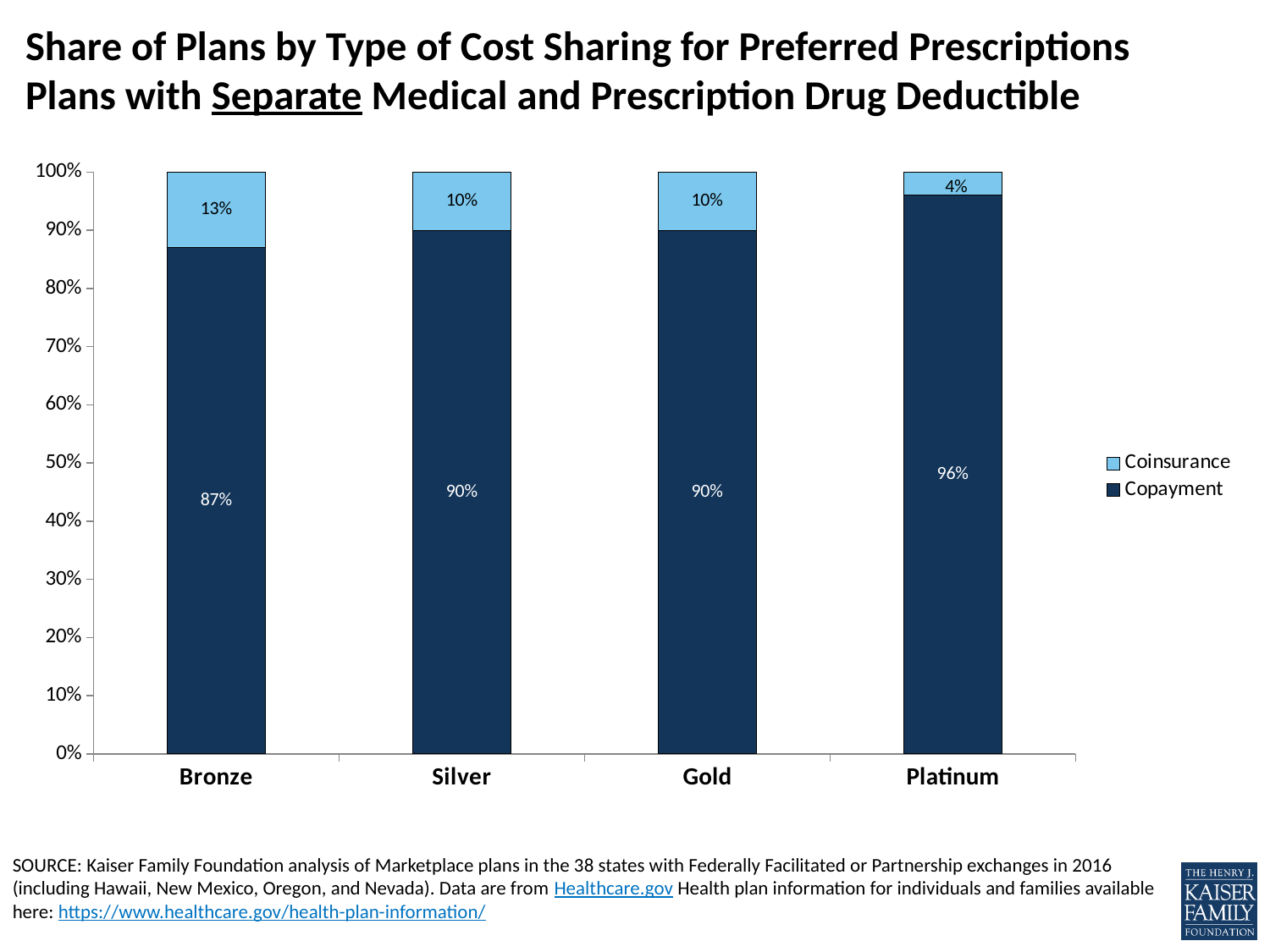
How many series does the legend list? 2 What kind of chart is shown on the slide? Stacked bar chart What is the Copayment share for Bronze plans? 87% How many metal tiers are shown on the x axis? 4 Which is larger, the Coinsurance share for Bronze or for Gold? Bronze What is the Coinsurance share for Platinum plans? 4% Which metal tier has the lowest Coinsurance share? Platinum Which metal tier has the highest Copayment share? Platinum Which series is shown in light blue in the legend? Coinsurance What is the Coinsurance share for Silver plans? 10% Does the Copayment share rise or fall from Bronze to Platinum? Rise What is the difference between the Copayment share for Platinum and for Bronze? 9 percentage points